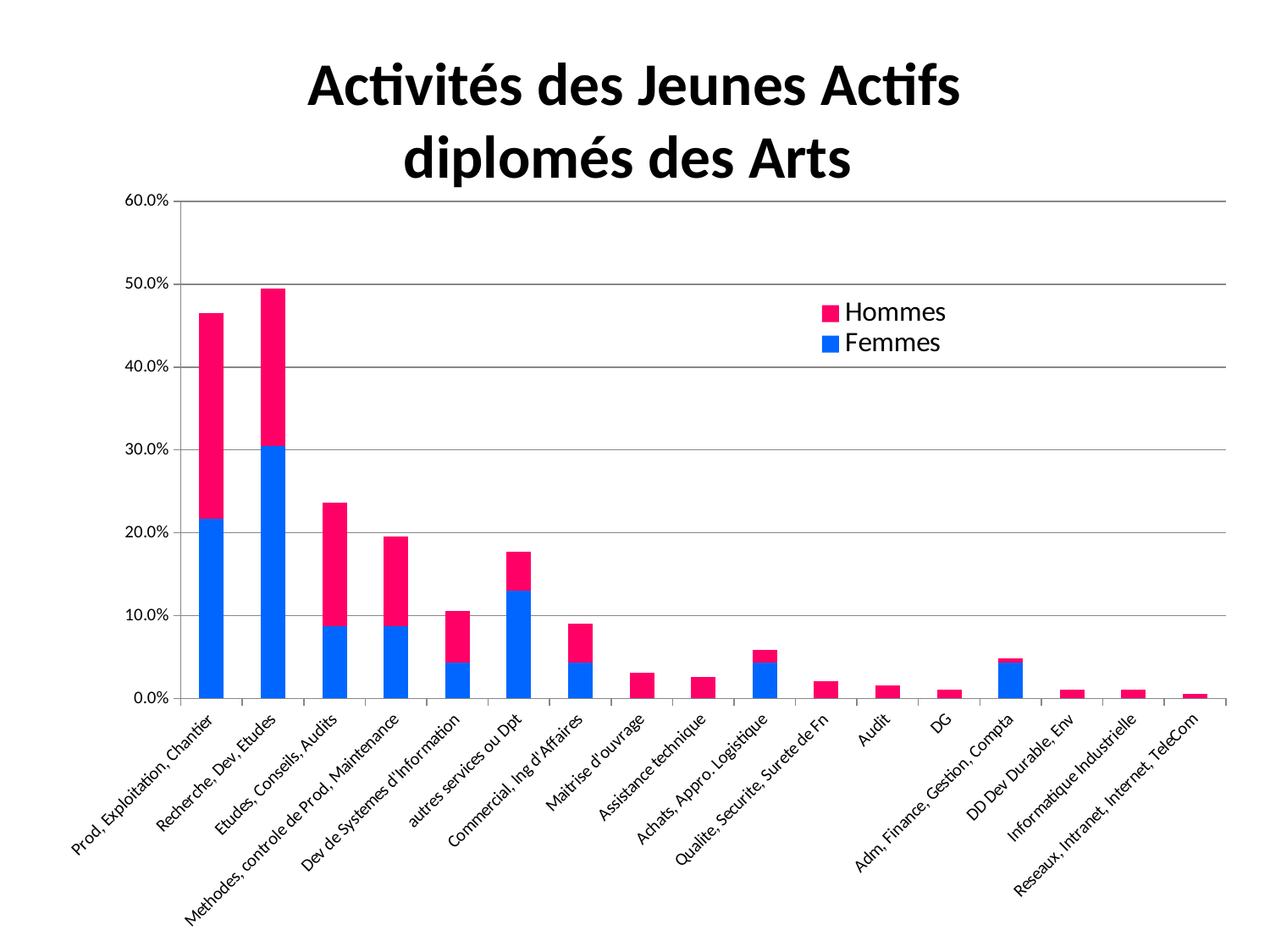
Which colour represents the Hommes series? Pink Which activity category has the lowest total bar? Reseaux, Intranet, Internet, TeleCom Is the total value for Prod, Exploitation, Chantier greater or less than 40.0%? greater What kind of chart is shown on the slide? Stacked bar chart Is the total value for Etudes, Conseils, Audits greater or less than 20.0%? greater How many activity categories are shown on the x axis? 17 Is the total value for autres services ou Dpt greater or less than 20.0%? less What is the title of the chart? Activités des Jeunes Actifs diplomés des Arts Which has the larger total bar: Etudes, Conseils, Audits or Methodes, controle de Prod, Maintenance? Etudes, Conseils, Audits How many series does the legend list? 2 Which activity category has the highest total bar? Recherche, Dev, Etudes